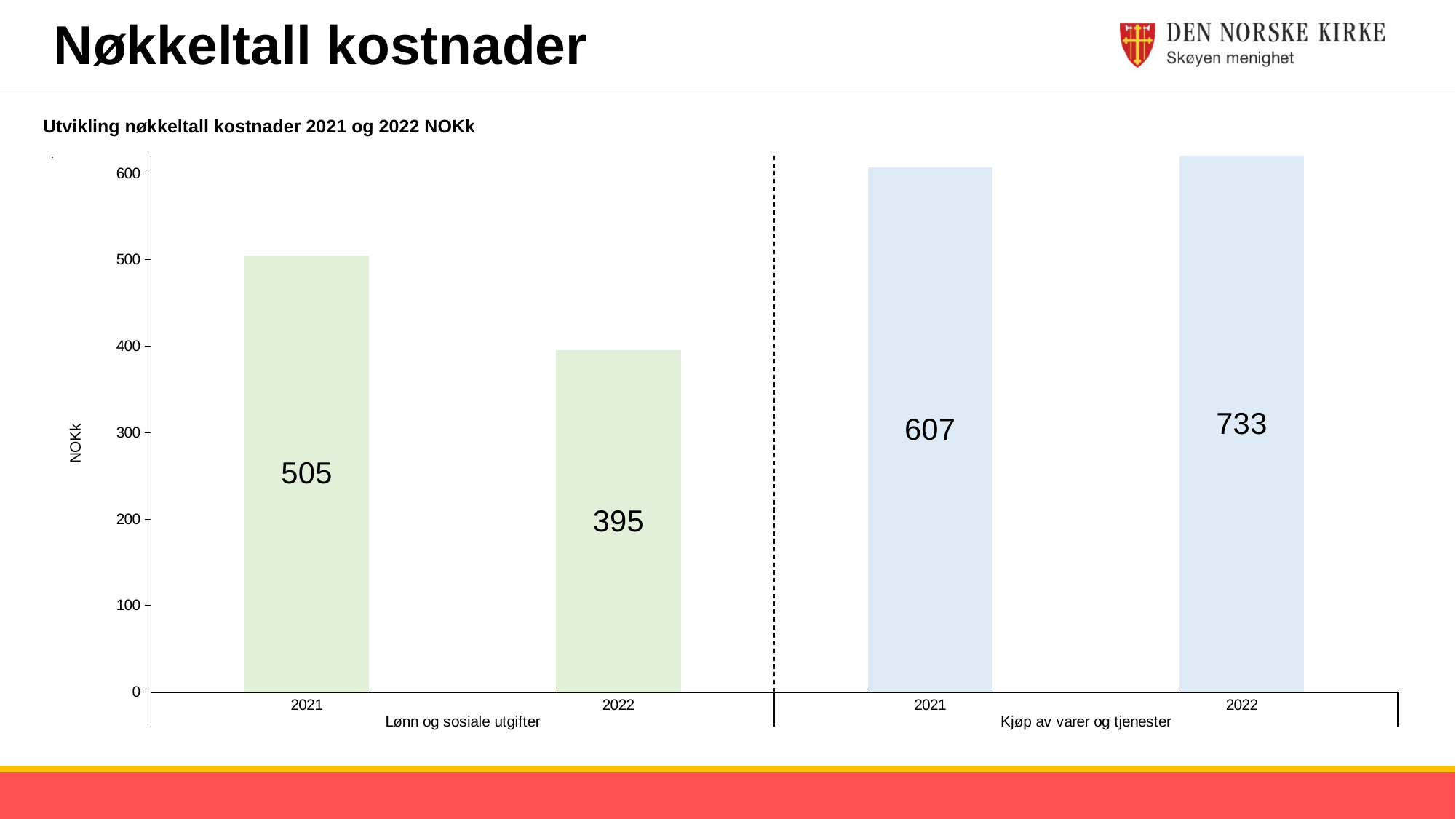
What is the value for Kjøp av varer og tjenester in 2021? 607 Did Lønn og sosiale utgifter rise or fall from 2021 to 2022? fall What is the value for Kjøp av varer og tjenester in 2022? 733 What is the value for Lønn og sosiale utgifter in 2021? 505 What kind of chart is shown on the slide? bar chart Which bar has the highest value on the chart? Kjøp av varer og tjenester 2022 What is the difference between the 2021 and 2022 values for Lønn og sosiale utgifter? 110 What is the value for Lønn og sosiale utgifter in 2022? 395 What is the title of the chart? Utvikling nøkkeltall kostnader 2021 og 2022 NOKk What is the difference between the 2022 and 2021 values for Kjøp av varer og tjenester? 126 Which is larger: Lønn og sosiale utgifter in 2021 or Kjøp av varer og tjenester in 2021? Kjøp av varer og tjenester in 2021 Which bar has the lowest value on the chart? Lønn og sosiale utgifter 2022